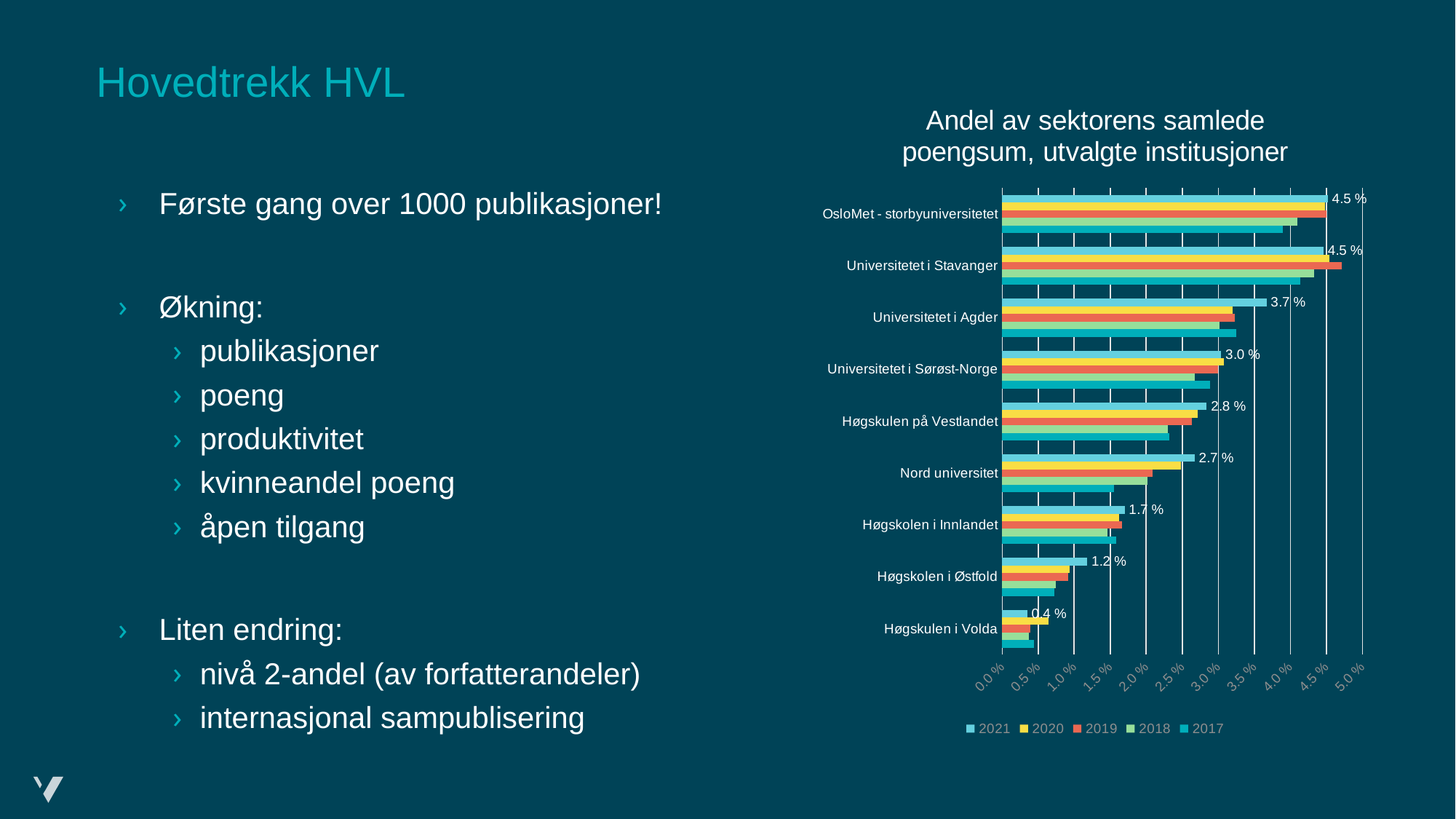
Which institution has the lowest 2021 value? Høgskulen i Volda Is the 2017 value for Nord universitet greater or less than 2.0 %? less What is the difference between the 2021 values for OsloMet - storbyuniversitetet and Høgskulen i Volda? 4.1 % What is the 2021 value for Universitetet i Agder? 3.7 % Which has the larger 2021 value, Nord universitet or Høgskolen i Innlandet? Nord universitet What is the 2021 value for Høgskulen i Volda? 0.4 % How many institutions are shown in the chart? 9 What is the difference between the 2021 values for Universitetet i Agder and Universitetet i Sørøst-Norge? 0.7 % What kind of chart is shown on the slide? Bar chart How many series does the legend list? 5 What is the 2021 value for Høgskolen i Østfold? 1.2 % What is the 2021 value for Høgskulen på Vestlandet? 2.8 %